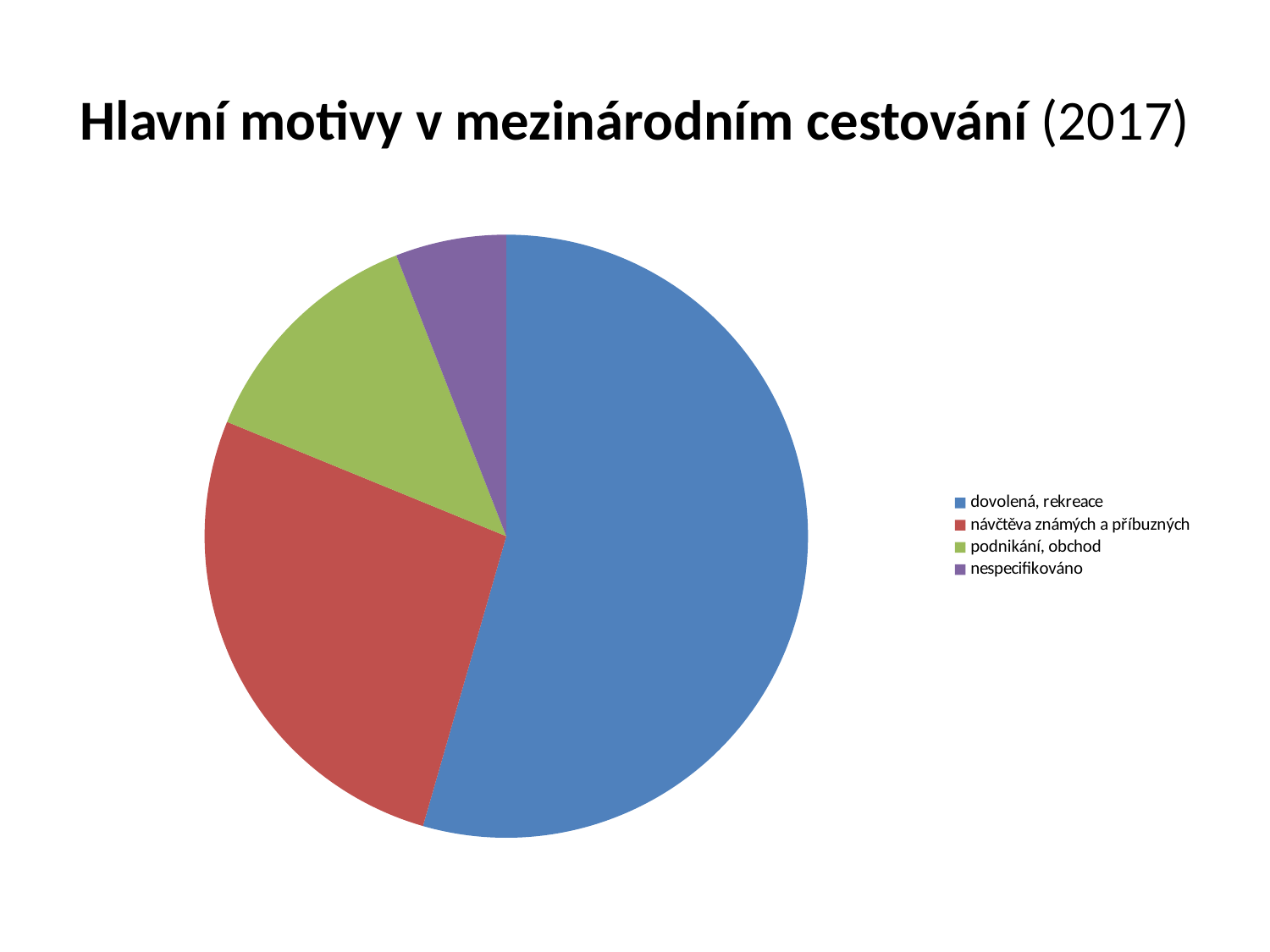
Which slice is larger: dovolená, rekreace or návčtěva známých a příbuzných? dovolená, rekreace Which slice is larger: podnikání, obchod or nespecifikováno? podnikání, obchod Which slice is larger: návčtěva známých a příbuzných or podnikání, obchod? návčtěva známých a příbuzných What is the title of the slide's chart? Hlavní motivy v mezinárodním cestování (2017) Does the slice for dovolená, rekreace take up more or less than half of the pie? more How many slices does the pie chart have? 4 Which category has the smallest slice of the pie? nespecifikováno What kind of chart is shown on the slide? pie chart Which category has the largest slice of the pie? dovolená, rekreace What colour is the slice for podnikání, obchod? green